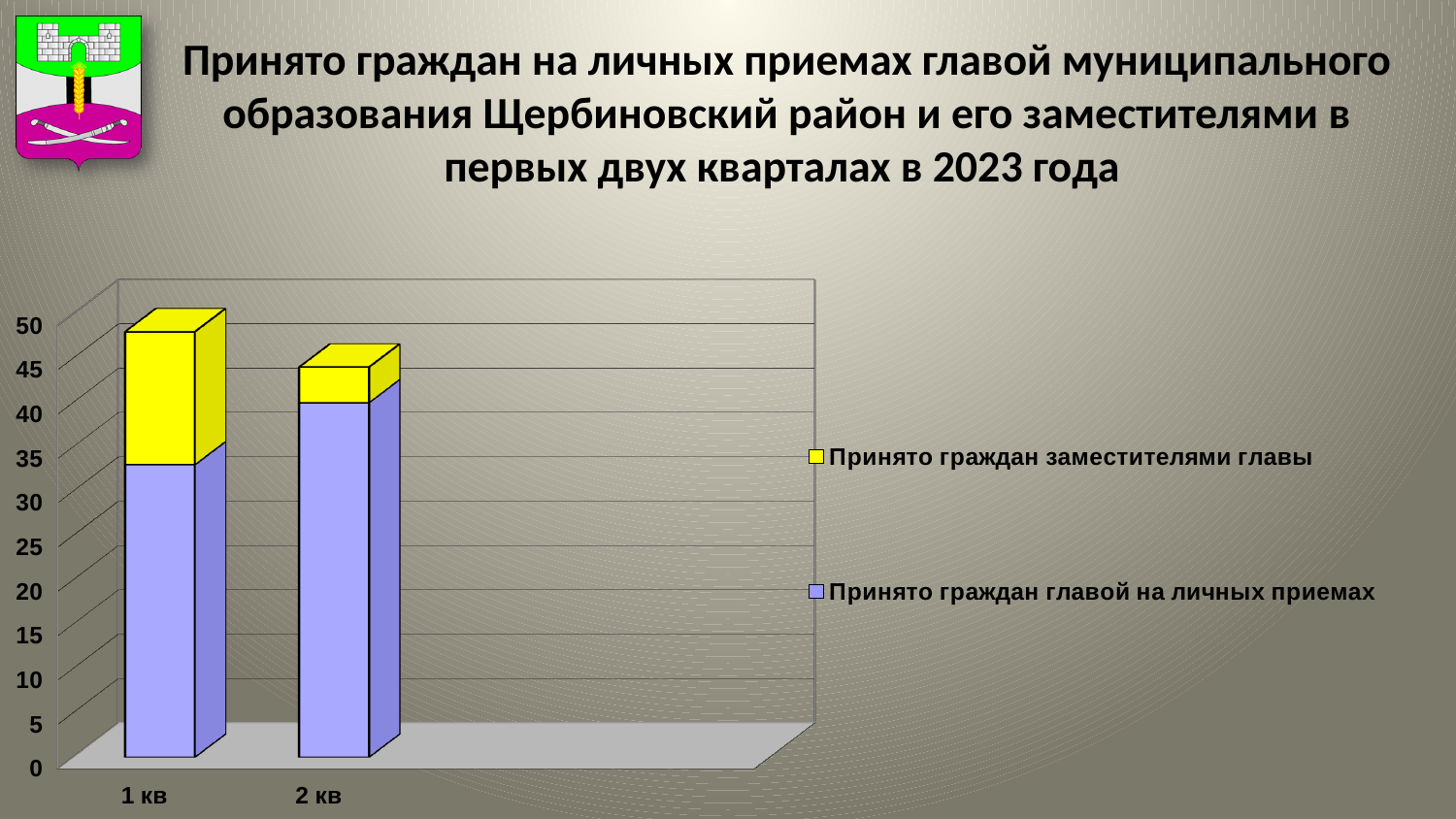
Is the total height of the stacked bar for 2 кв greater or less than 40? greater Which quarter has the larger value for 'Принято граждан заместителями главы', 1 кв or 2 кв? 1 кв Is the value for 'Принято граждан главой на личных приемах' in 2 кв greater or less than 35? greater Which series is shown in yellow in the chart? Принято граждан заместителями главы Is the total height of the stacked bar for 1 кв greater or less than 45? greater How many series does the chart's legend list? 2 What kind of chart is shown on the slide? bar chart Which quarter has the larger value for 'Принято граждан главой на личных приемах', 1 кв or 2 кв? 2 кв How many categories (quarters) are shown on the x axis of the chart? 2 Which series is shown in purple in the chart? Принято граждан главой на личных приемах